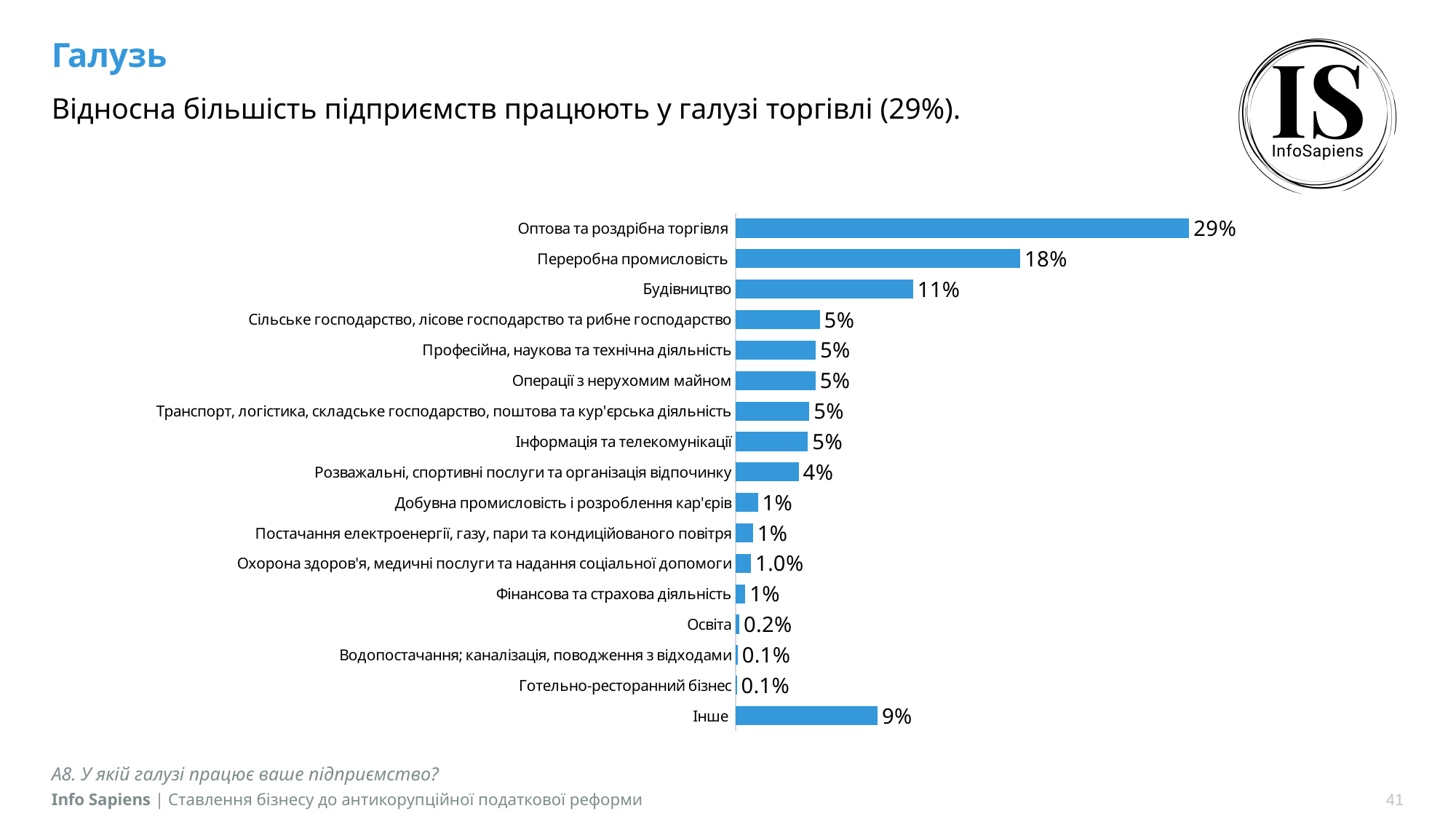
What is the value shown for Переробна промисловість? 18% What is the value shown for Будівництво? 11% What is the value shown for Освіта? 0.2% Which is larger: the value for Розважальні, спортивні послуги та організація відпочинку or the value for Інше? Інше What is the value shown for Інше? 9% What is the difference between the values for Будівництво and Інше? 2% What type of chart is shown on the slide? Bar chart What percentage of enterprises work in Оптова та роздрібна торгівля? 29% What is the value shown for Охорона здоров'я, медичні послуги та надання соціальної допомоги? 1.0% Which category has the highest value in the chart? Оптова та роздрібна торгівля What is the difference between the values for Оптова та роздрібна торгівля and Переробна промисловість? 11% How many categories are shown in the chart? 17